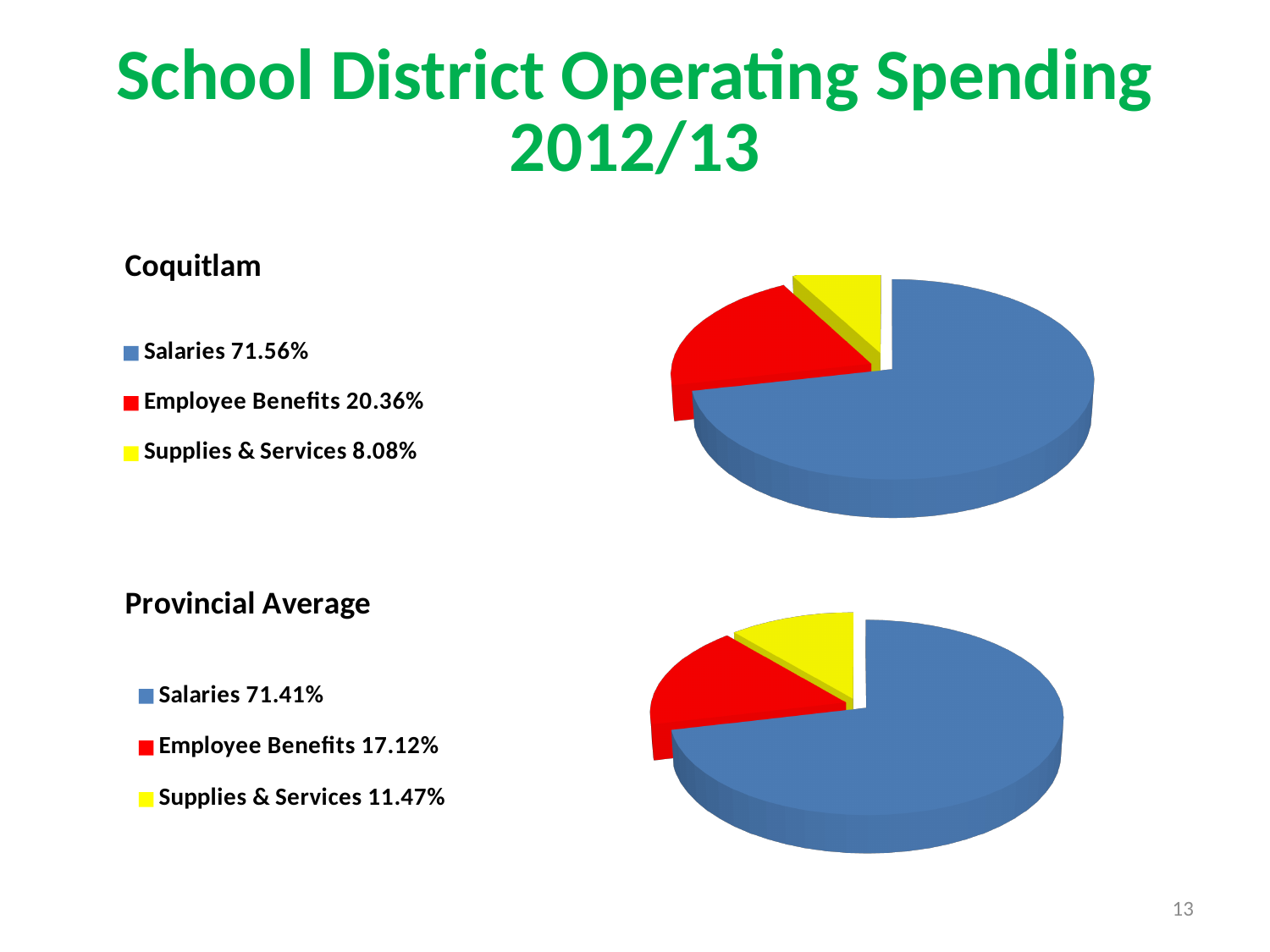
In the Coquitlam pie chart, what is the difference between the Employee Benefits share and the Supplies & Services share? 12.28% In the Coquitlam pie chart, what share of operating spending goes to Employee Benefits? 20.36% In the Provincial Average pie chart, which category has the smallest share? Supplies & Services In the Coquitlam pie chart, which category has the smallest share? Supplies & Services In the Coquitlam pie chart, which category has the largest share? Salaries In the Coquitlam pie chart, what share of operating spending goes to Salaries? 71.56% Which is larger: the Employee Benefits share in the Coquitlam chart or the Employee Benefits share in the Provincial Average chart? Coquitlam What kind of chart is used for the Coquitlam data? Pie chart In the Provincial Average pie chart, what share of operating spending goes to Employee Benefits? 17.12% How many categories does the Provincial Average pie chart show? 3 In the Provincial Average pie chart, what colour represents Supplies & Services? Yellow In the Provincial Average pie chart, what share of operating spending goes to Supplies & Services? 11.47%